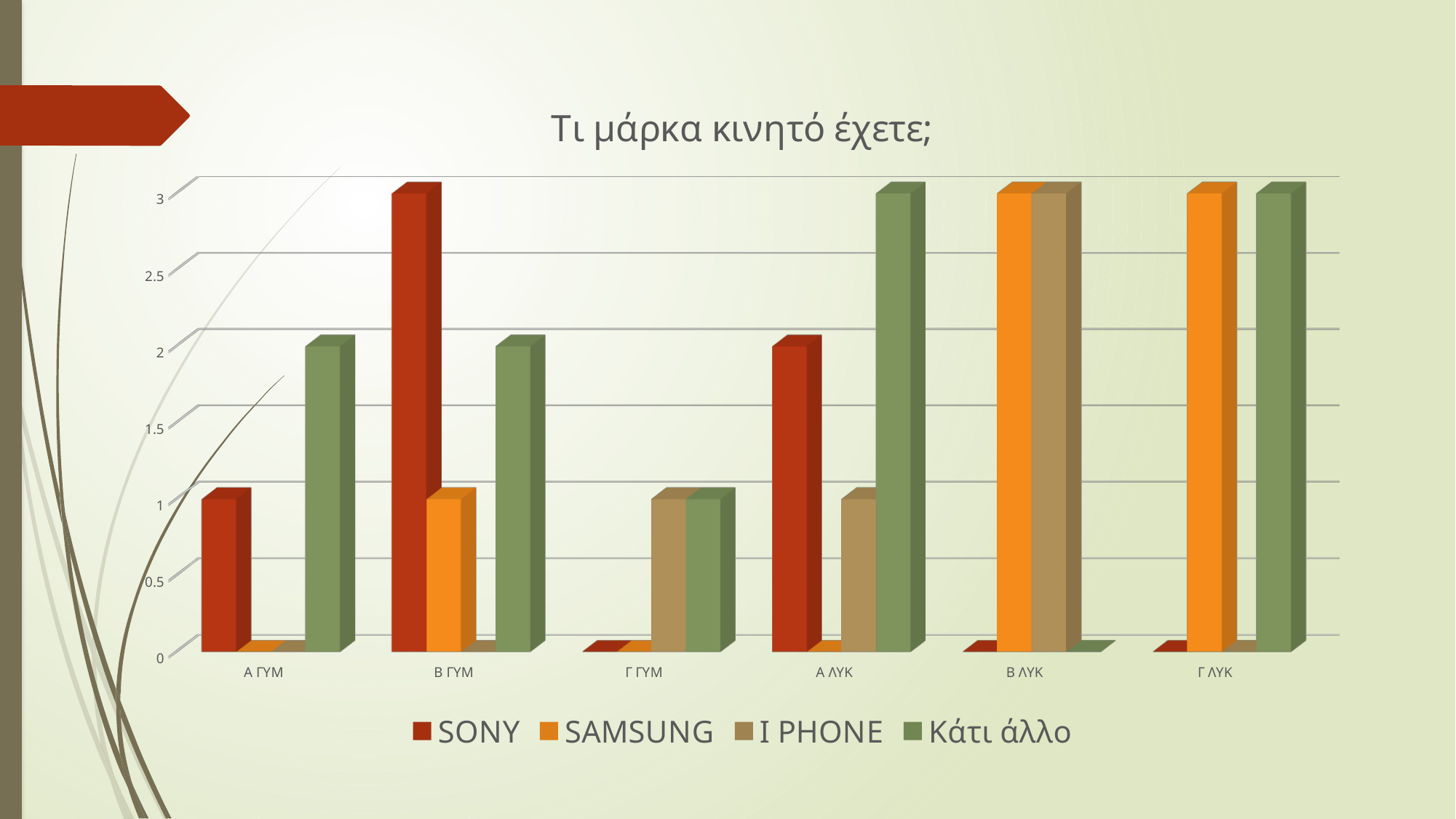
What is the difference between the SONY value and the SAMSUNG value in Β ΓΥΜ? 2 Is the value for Κάτι άλλο in Γ ΛΥΚ greater or less than 2? greater Which is larger in Α ΛΥΚ, the SONY value or the Κάτι άλλο value? Κάτι άλλο What is the value for SONY in Β ΓΥΜ? 3 Which category has the highest SONY value? Β ΓΥΜ Which series is shown in green in the legend? Κάτι άλλο How many series does the legend list? 4 What is the title of the chart? Τι μάρκα κινητό έχετε; What kind of chart is shown on the slide? bar chart What is the value for Κάτι άλλο in Α ΓΥΜ? 2 How many categories are shown on the x axis? 6 What is the value for SAMSUNG in Β ΛΥΚ? 3